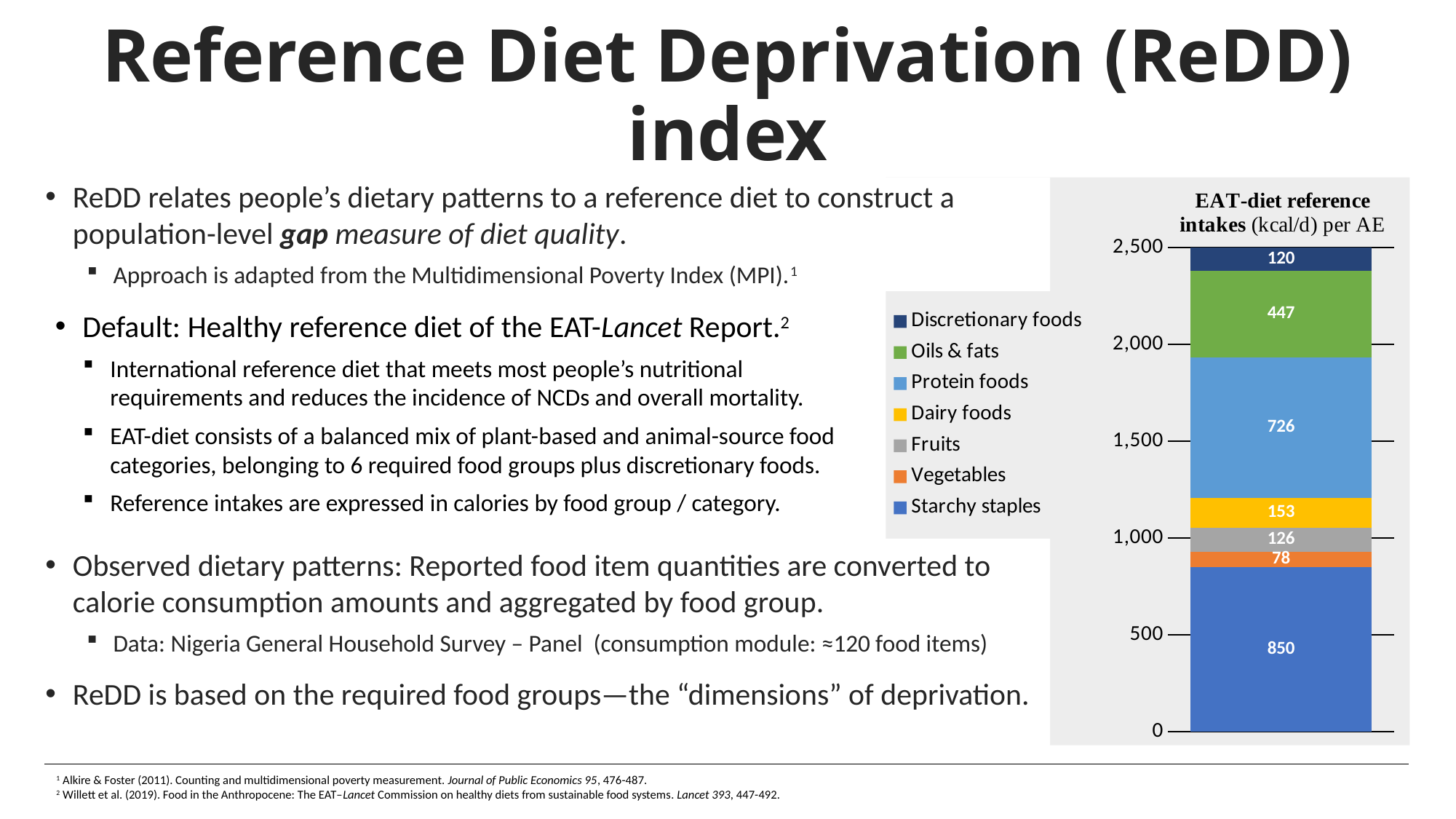
What unit is given in the chart title for the reference intakes? kcal/d What is the EAT-diet reference intake for Starchy staples? 850 How many food groups does the legend of the chart list? 7 What is the difference between the reference intakes for Starchy staples and Protein foods? 124 What kind of chart is shown on the slide? Stacked bar chart Which has a larger reference intake, Dairy foods or Fruits? Dairy foods What is the EAT-diet reference intake for Vegetables? 78 Which food group has the highest reference intake in the chart? Starchy staples What is the EAT-diet reference intake for Protein foods? 726 What is the total of the stacked bar in the EAT-diet reference intakes chart? 2,500 Which food group has the lowest reference intake in the chart? Vegetables What is the EAT-diet reference intake for Oils & fats? 447